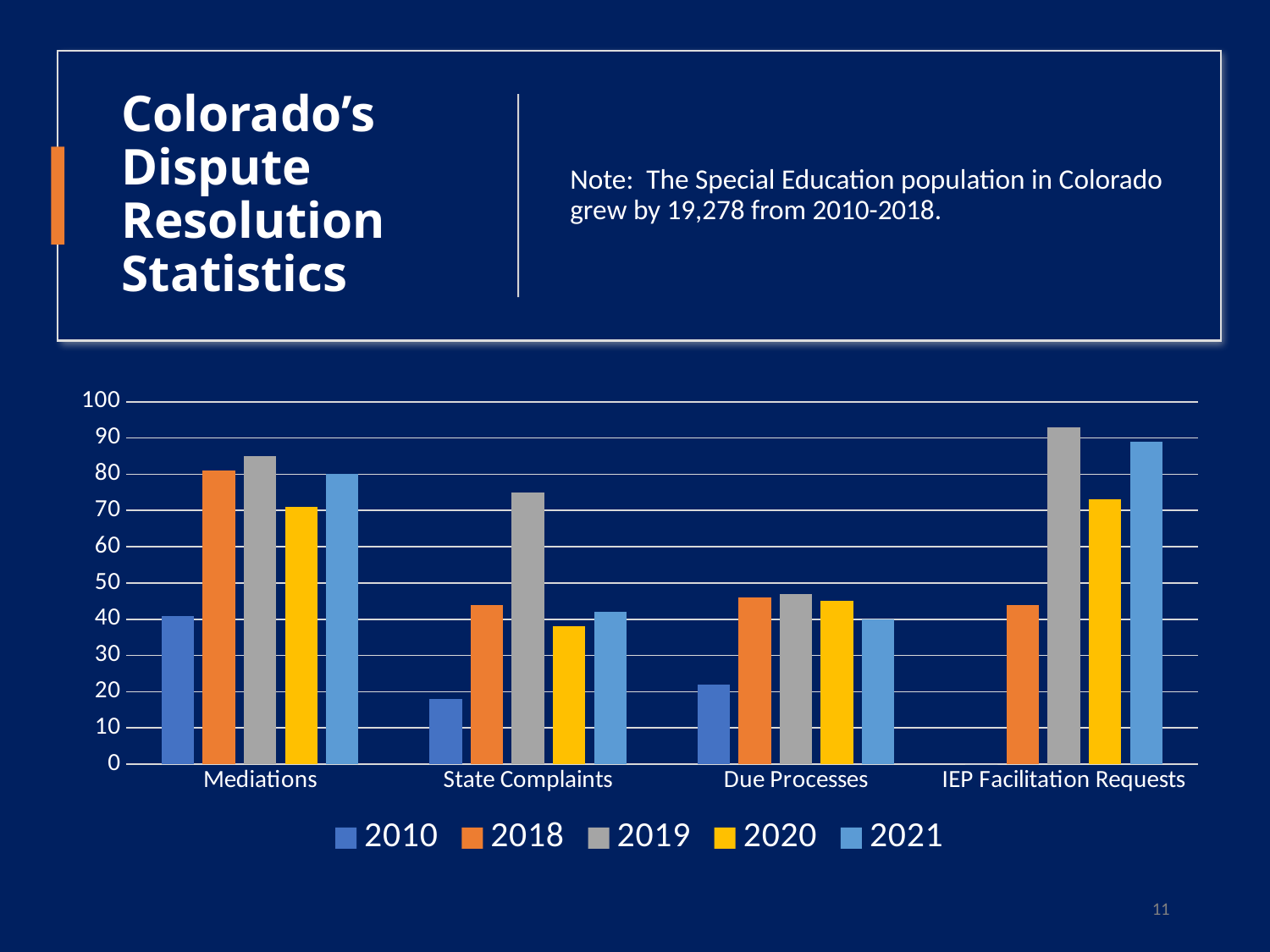
Is the value for IEP Facilitation Requests in 2019 greater or less than 90? greater Is the value for State Complaints in 2010 greater or less than 20? less Which year has the highest value for Mediations? 2019 Which colour represents the 2020 series in the legend? yellow How many categories are shown on the x axis? 4 How many series does the legend list? 5 Which year has the lowest value for Mediations? 2010 For IEP Facilitation Requests, which is larger: the value for 2021 or the value for 2020? 2021 Which year has the lowest value for Due Processes? 2010 What kind of chart is shown on the slide? bar chart Is the value for State Complaints in 2019 greater or less than 70? greater For State Complaints, which is larger: the value for 2019 or the value for 2020? 2019